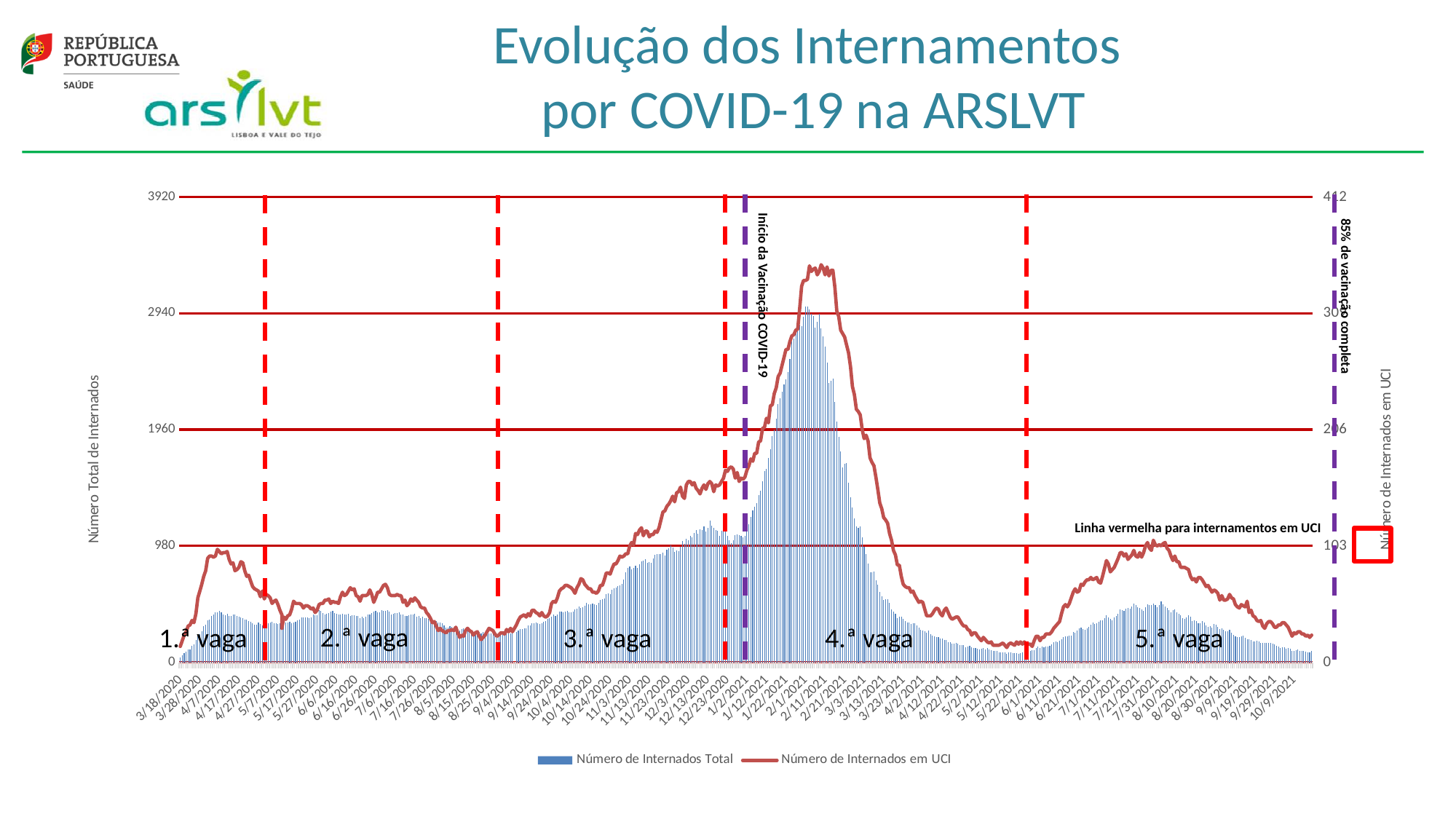
What is the title of the chart on the slide? Evolução dos Internamentos por COVID-19 na ARSLVT Is the peak of Número de Internados Total during the 4.ª vaga greater or less than 1960? greater What kind of chart is shown on the slide? A combined bar and line chart Which wave has the highest peak of Número de Internados Total? 4.ª vaga Which series is drawn as a red line? Número de Internados em UCI How many series does the legend list? 2 Is the peak of Número de Internados em UCI during the 4.ª vaga greater or less than 206 on the right axis? greater Which is larger: the peak of Número de Internados Total in the 4.ª vaga or in the 1.ª vaga? 4.ª vaga How many waves (vagas) are labelled on the chart? 5 Between the peak of the 4.ª vaga and 5/12/2021, do the values of Número de Internados Total rise or fall? fall What is the highest value shown on the left vertical axis? 3920 Is the peak of Número de Internados Total during the 5.ª vaga greater or less than 980? less